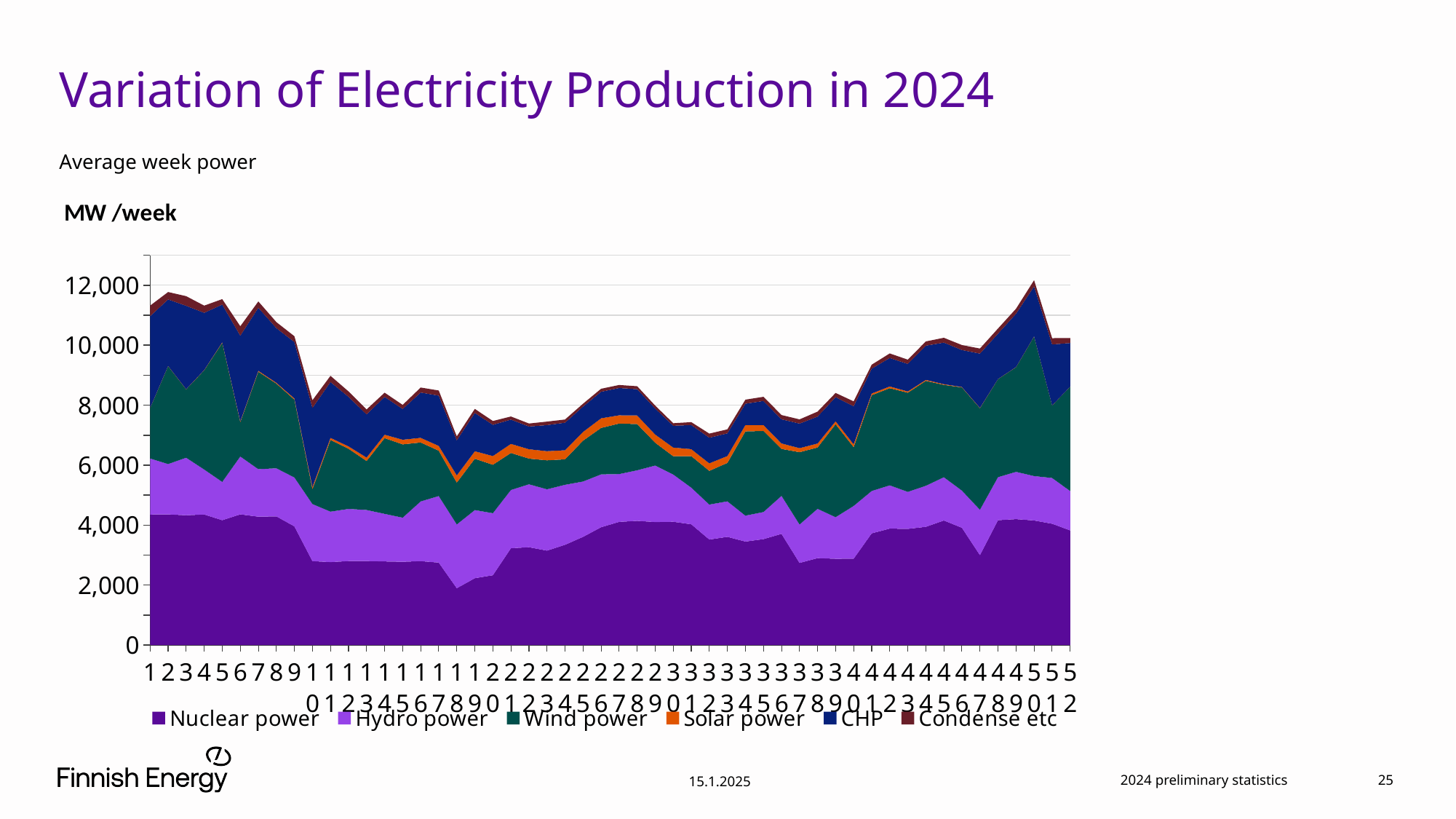
Is the total stacked value larger in week 1 or in week 20? Week 1 Is the total stacked value for week 20 greater or less than 8,000? less Is the total stacked value for week 1 greater or less than 10,000? greater How many weeks are plotted along the x axis? 52 What is the title of the chart on the slide? Variation of Electricity Production in 2024 What unit is shown on the y axis label? MW /week Does the total stacked value rise or fall from week 40 to week 50? Rise Is the value for Nuclear power in week 10 greater or less than 4,000? less What kind of chart is shown on the slide? Stacked area chart How many series does the legend list? 6 Which week has the highest total stacked value? Week 50